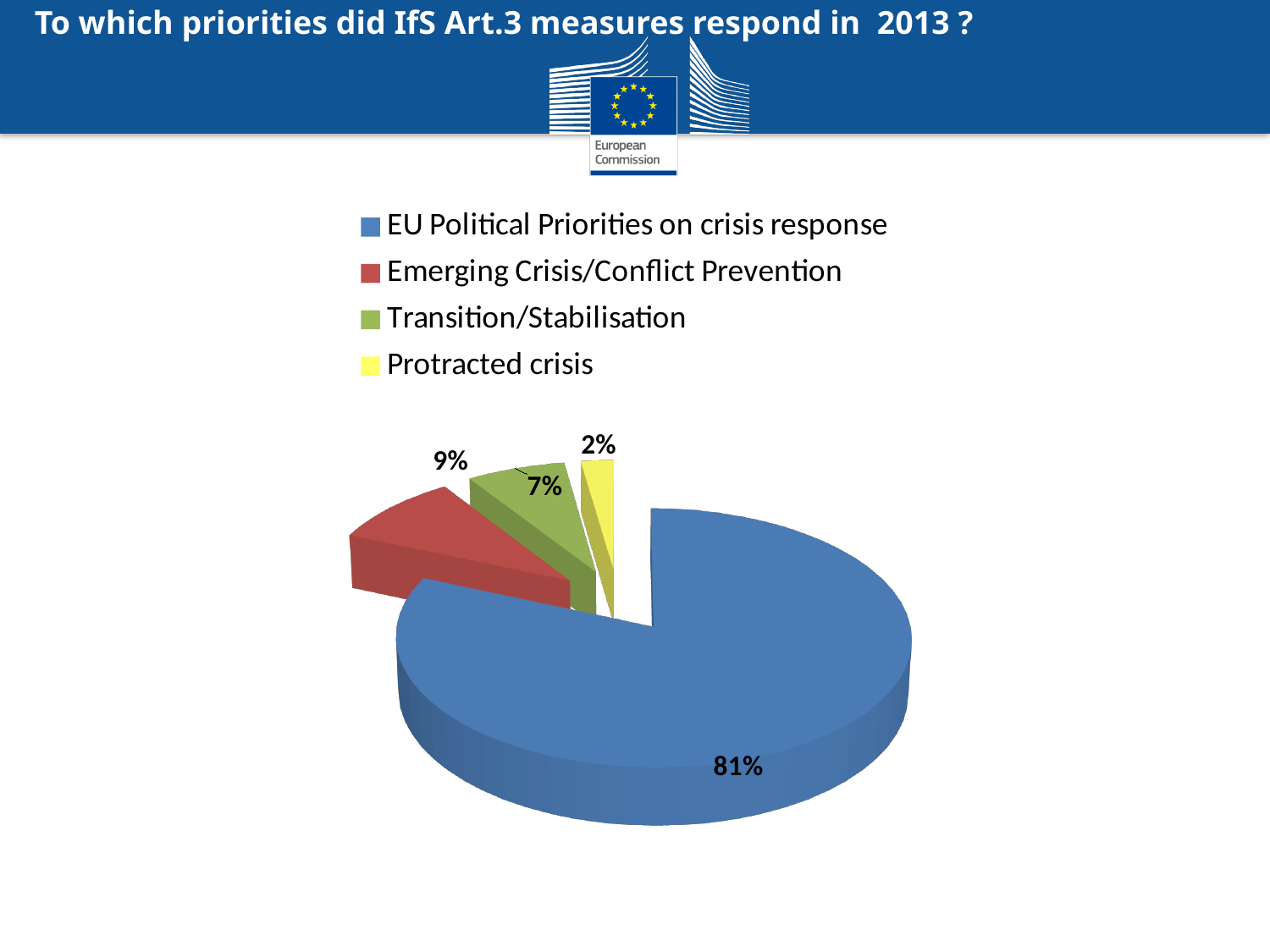
What share of the pie does Protracted crisis account for? 2% What share of the pie does Transition/Stabilisation account for? 7% Which category has the smallest slice of the pie? Protracted crisis Which is larger, the share for Emerging Crisis/Conflict Prevention or the share for Transition/Stabilisation? Emerging Crisis/Conflict Prevention What is the difference in percentage points between Transition/Stabilisation and Protracted crisis? 5 percentage points How many categories does the pie chart show? 4 What is the difference in percentage points between EU Political Priorities on crisis response and Emerging Crisis/Conflict Prevention? 72 percentage points Which category has the largest slice of the pie? EU Political Priorities on crisis response What share of the pie does Emerging Crisis/Conflict Prevention account for? 9% What kind of chart is shown on the slide? Pie chart Which colour represents Protracted crisis in the legend? Yellow